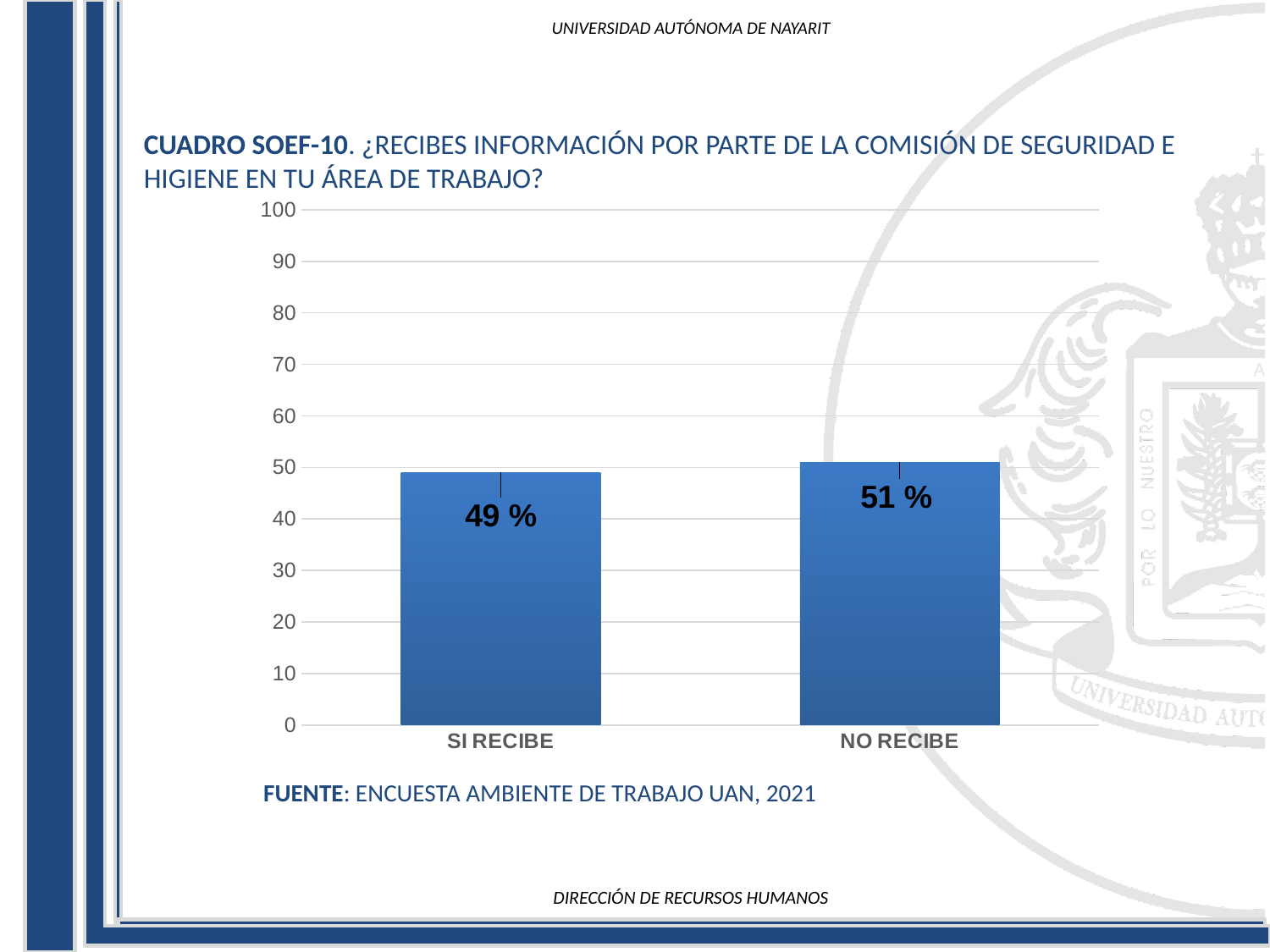
What is the difference between the values for NO RECIBE and SI RECIBE? 2 % How many categories are shown on the x axis? 2 What is the maximum value shown on the y axis? 100 Which category has the lowest value? SI RECIBE Is the value for NO RECIBE greater or less than 60? less What is the total of the two bar values? 100 % Which category has the highest value? NO RECIBE Is the value for SI RECIBE greater or less than 50? less Which is larger, the value for SI RECIBE or the value for NO RECIBE? NO RECIBE What is the value for NO RECIBE? 51 % What is the value for SI RECIBE? 49 % What kind of chart is shown on the slide? bar chart